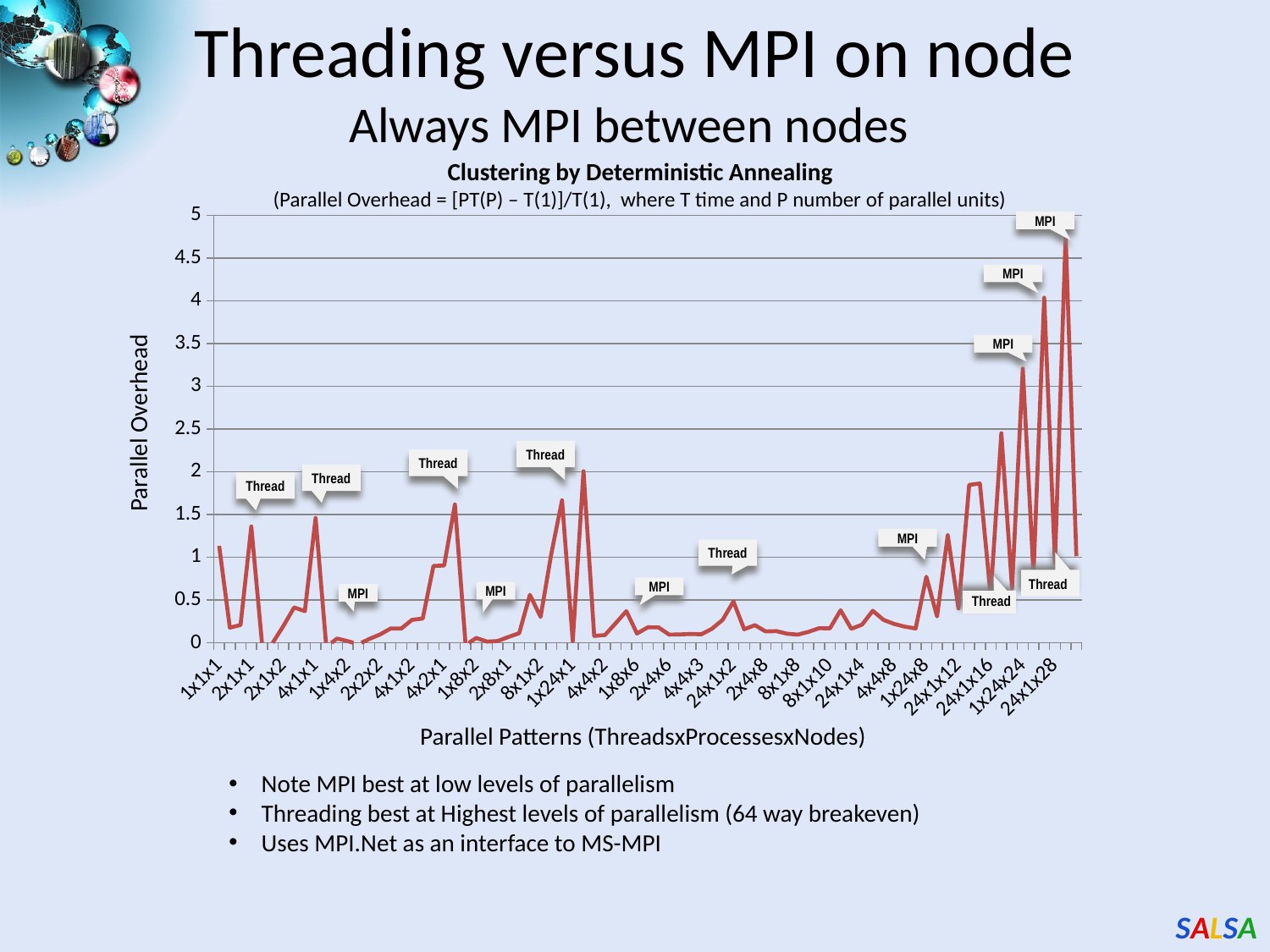
Do the peaks of the line generally rise or fall moving from left to right along the x axis? rise Is the value for 1x1x1 greater or less than 1.5? less What is the label on the x axis of the chart? Parallel Patterns (ThreadsxProcessesxNodes) What is the title of the chart? Clustering by Deterministic Annealing What kind of chart is shown on the slide? line chart Is the highest value plotted on the chart greater or less than 4.5? greater Is the value for 1x1x1 greater or less than 0.5? greater